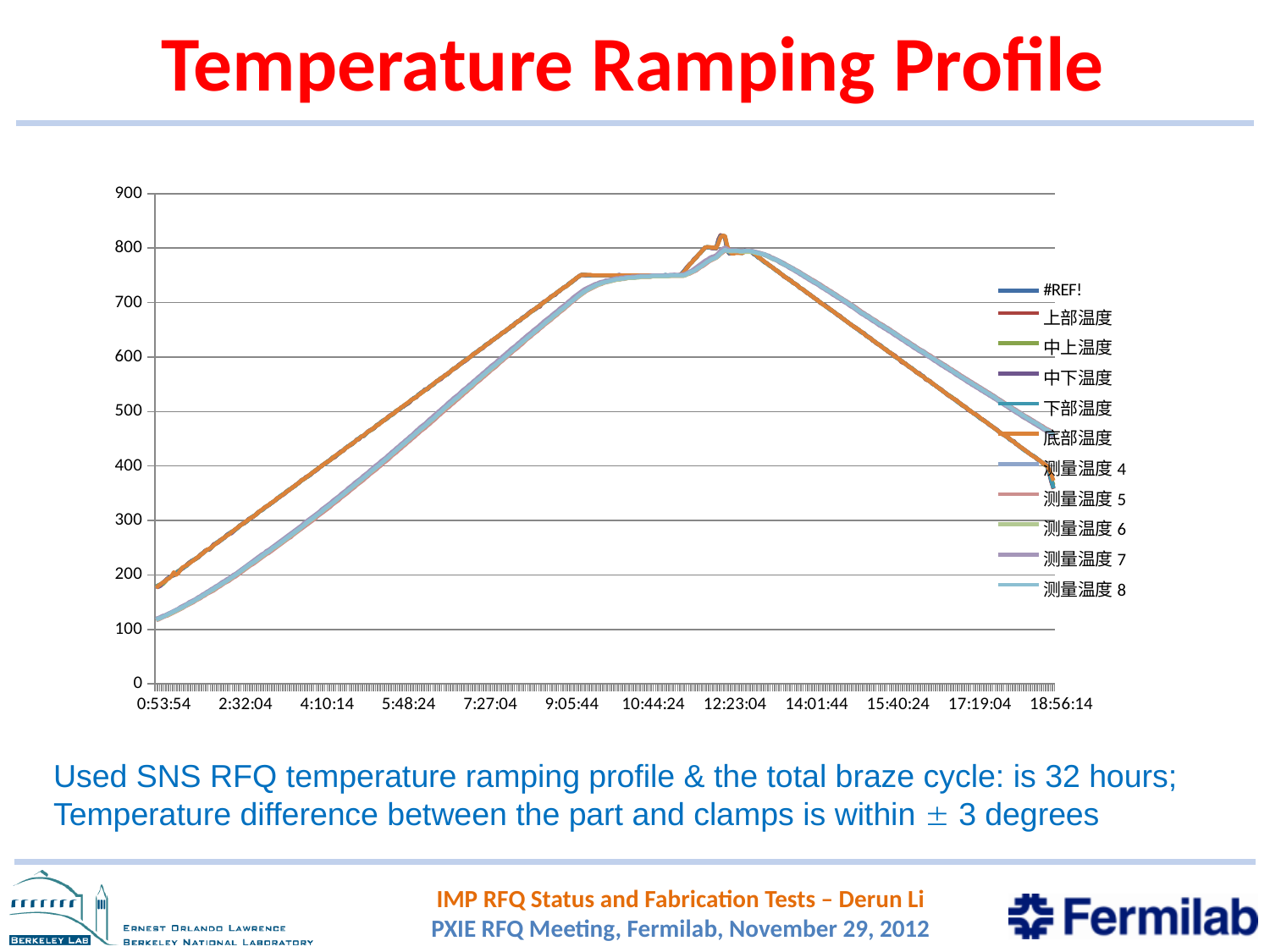
How many series does the legend list? 11 What is the title of the slide containing the chart? Temperature Ramping Profile Do the temperature values rise or fall between 0:53:54 and 9:05:44? rise What kind of chart is shown on the slide? line chart Is the temperature of the lines at 10:44:24 greater or less than 600? greater Do the temperature values rise or fall between 12:23:04 and 18:56:14? fall Is the temperature of the lines at 0:53:54 greater or less than 300? less What is the first entry in the chart's legend? #REF! How many time labels are shown along the x axis? 12 Is the peak temperature reached by the lines greater or less than 700? greater What is the highest value shown on the y axis? 900